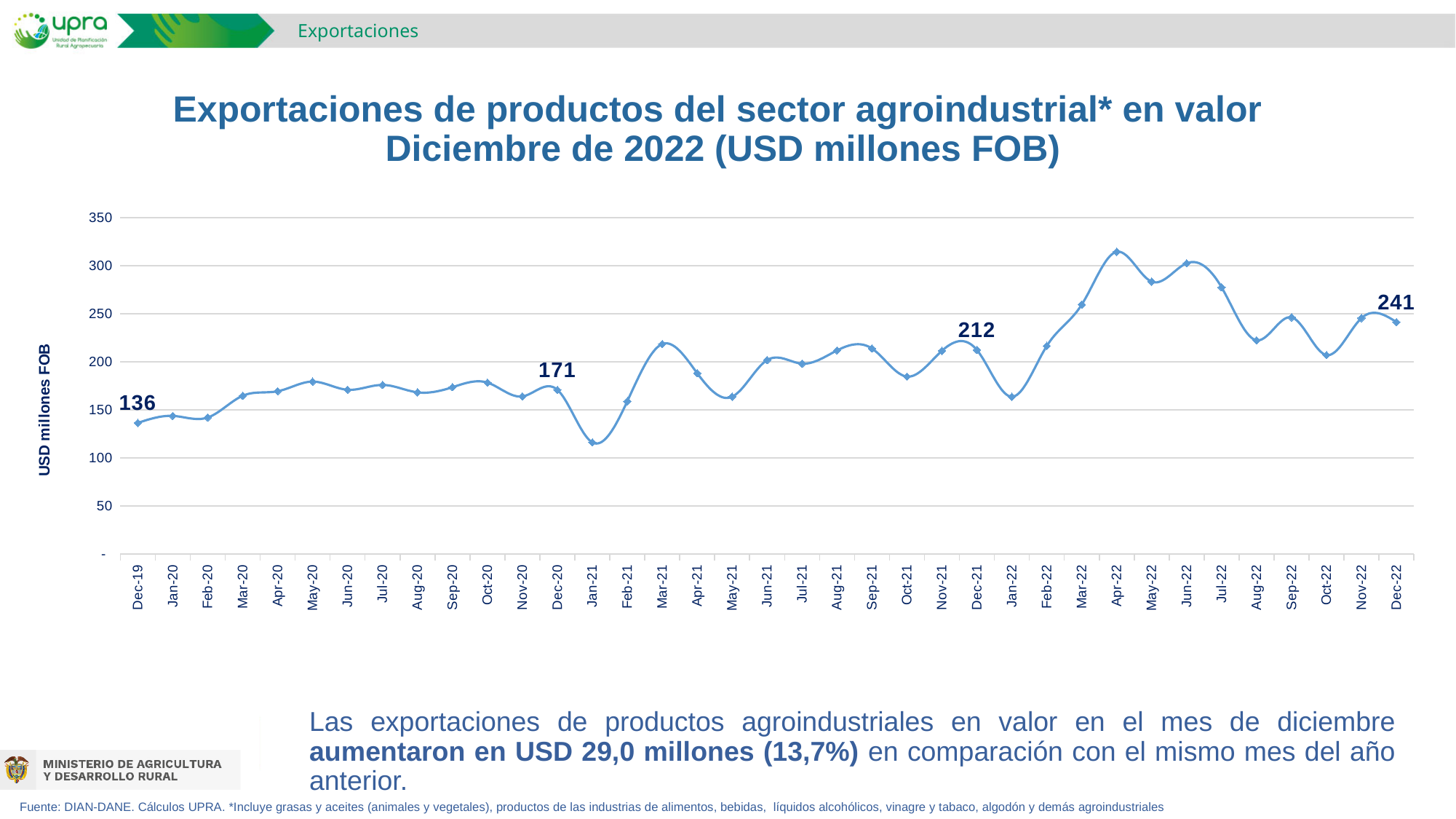
What is the value for Dec-19? 136 Which is larger, the value for Dec-22 or the value for Dec-19? Dec-22 What is the value for Dec-20? 171 What is the value for Dec-21? 212 Which month has the lowest value on the chart? Jan-21 Is the value for Apr-22 greater or less than 300? greater What is the difference between the values for Dec-22 and Dec-21? 29 How many monthly data points are plotted on the chart? 37 What kind of chart is shown on the slide? line chart Which month has the highest value on the chart? Apr-22 Is the value for Jan-21 greater or less than 150? less What is the value for Dec-22? 241